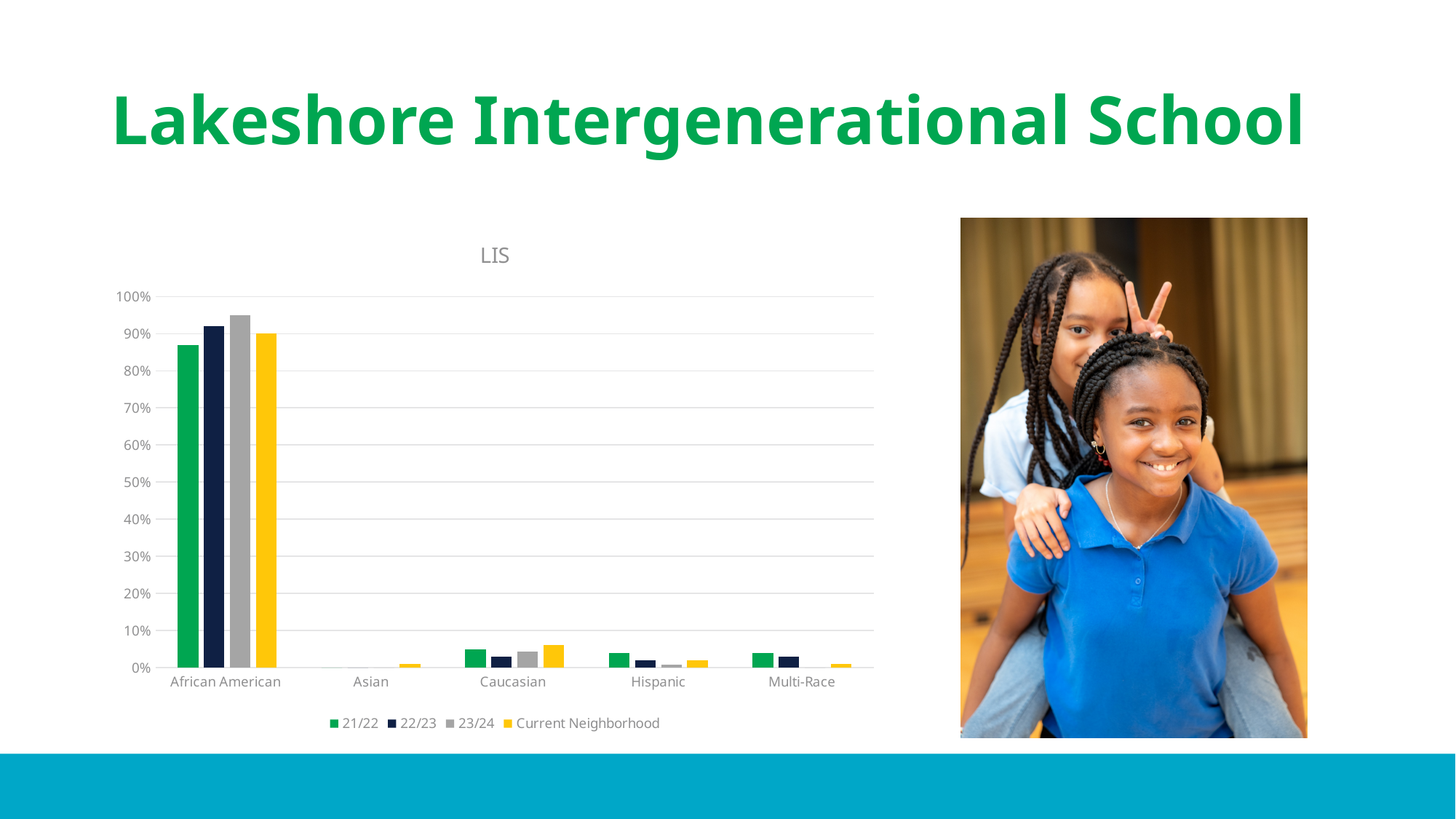
What is the title of the chart? LIS Is the 23/24 value for African American greater or less than 90%? greater For Hispanic, which is larger: the 21/22 value or the 23/24 value? 21/22 Which series is shown in yellow in the chart legend? Current Neighborhood How many categories are shown on the x axis of the chart? 5 What kind of chart is shown on the slide? bar chart For African American, which is larger: the 21/22 value or the 23/24 value? 23/24 Is the 21/22 value for African American greater or less than 80%? greater Is the Current Neighborhood value for Caucasian greater or less than 10%? less Which category has the highest values in the chart? African American Which category has the lowest values in the chart? Asian How many series does the chart legend list? 4